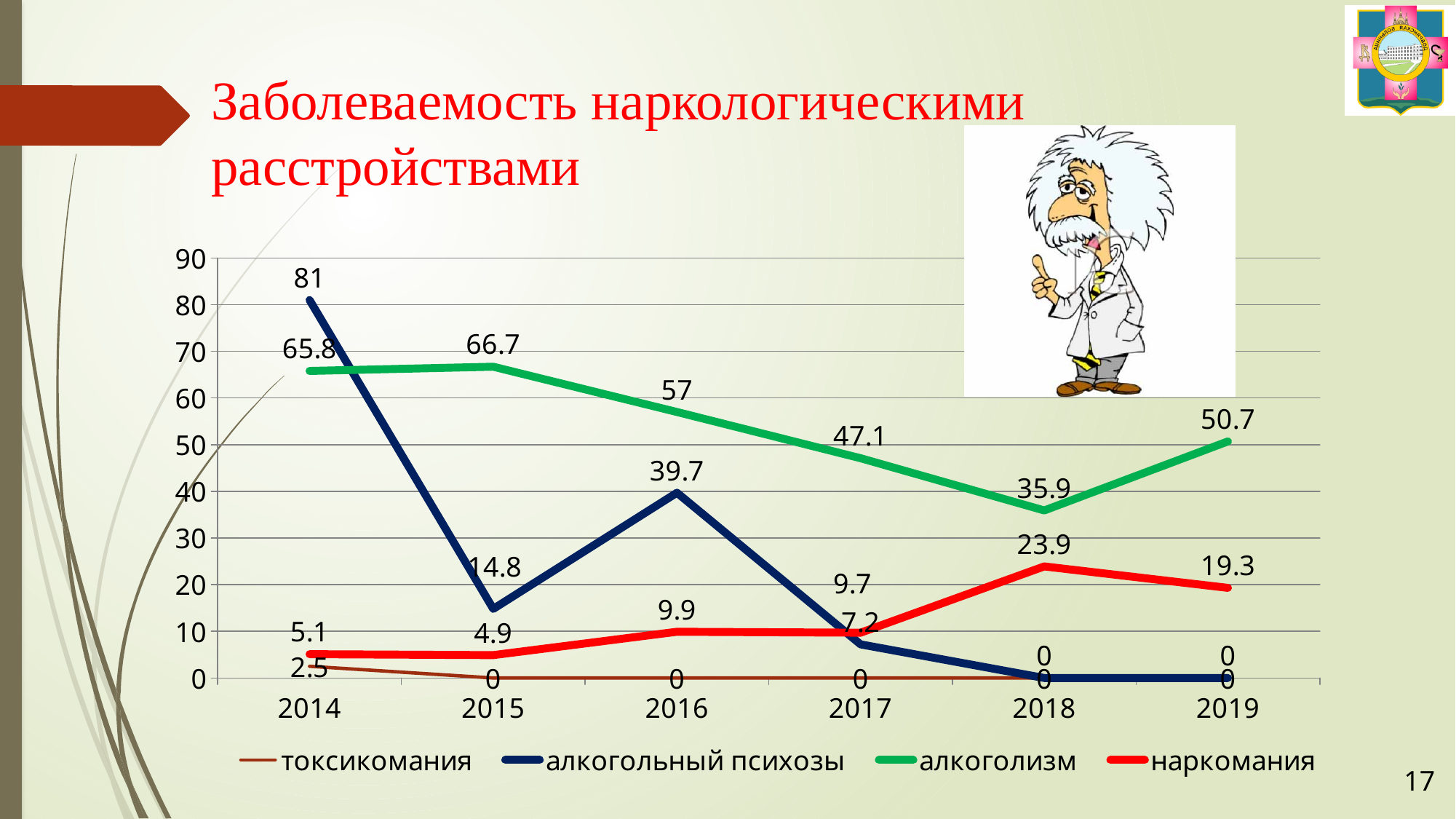
What is the value for наркомания in 2018? 23.9 How many years are shown on the x axis? 6 What is the difference between the алкоголизм values in 2015 and 2016? 9.7 What is the value for алкоголизм in 2019? 50.7 Which is larger in 2016: алкогольный психозы or наркомания? алкогольный психозы How many series does the legend list? 4 What is the value for алкогольный психозы in 2014? 81 Does the value for алкоголизм rise or fall from 2015 to 2018? fall What type of chart is shown on the slide? line chart In which year is the value for наркомания the highest? 2018 What is the value for токсикомания in 2014? 2.5 In which year is the value for алкоголизм the lowest? 2018